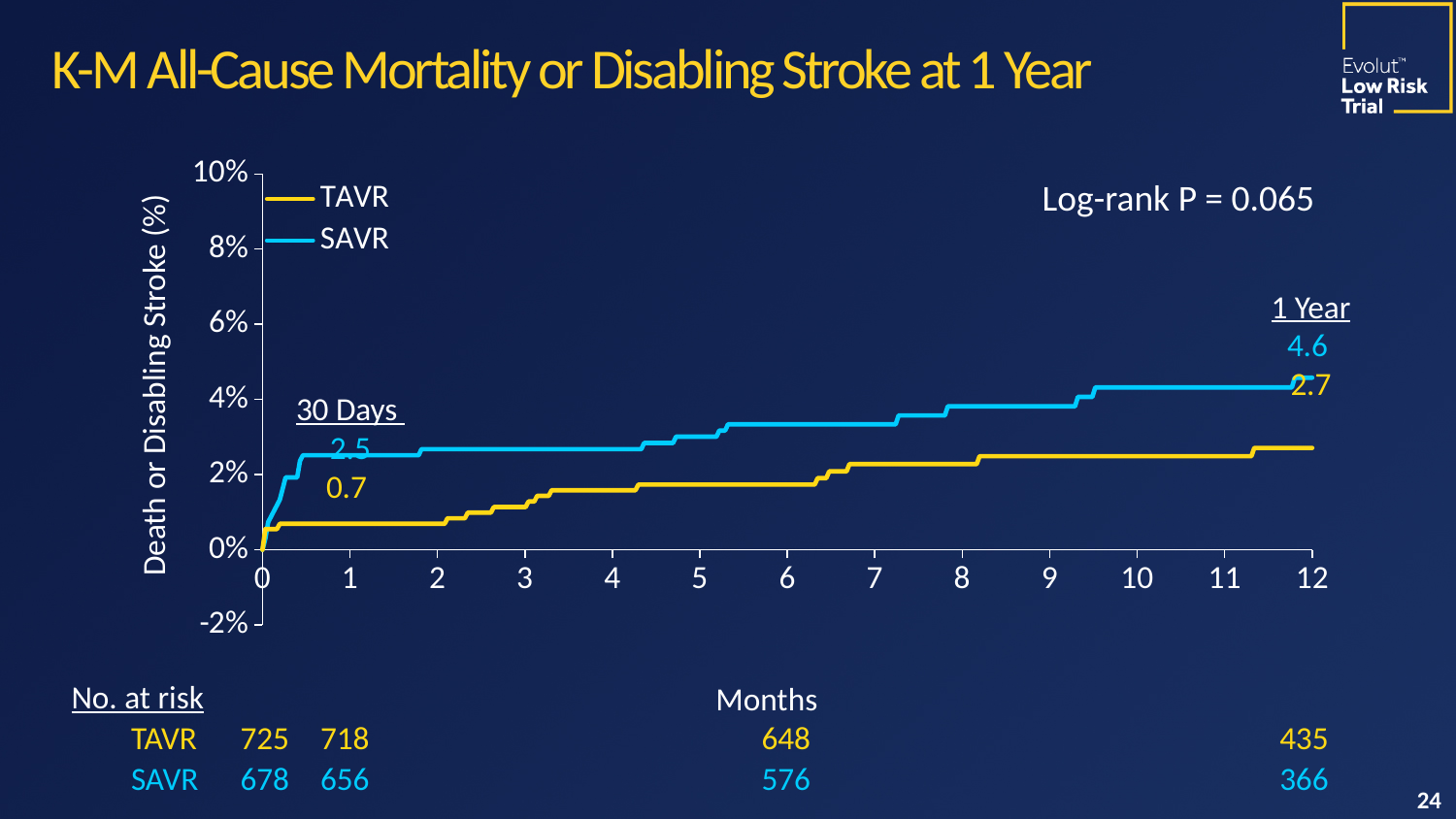
What is the 1 Year value for TAVR? 2.7 How many series does the legend list? 2 What is the difference between the SAVR and TAVR values at 30 Days? 1.8 What is the title of the chart? K-M All-Cause Mortality or Disabling Stroke at 1 Year Is the SAVR curve at 12 months greater or less than 4%? greater What is the Log-rank P value shown on the chart? 0.065 What is the 30 Days value for TAVR? 0.7 Which series has the higher value at 1 Year, TAVR or SAVR? SAVR What is the 1 Year value for SAVR? 4.6 What is the difference between the SAVR and TAVR values at 1 Year? 1.9 Do the TAVR and SAVR curves rise or fall as months increase along the x axis? rise What is the 30 Days value for SAVR? 2.5